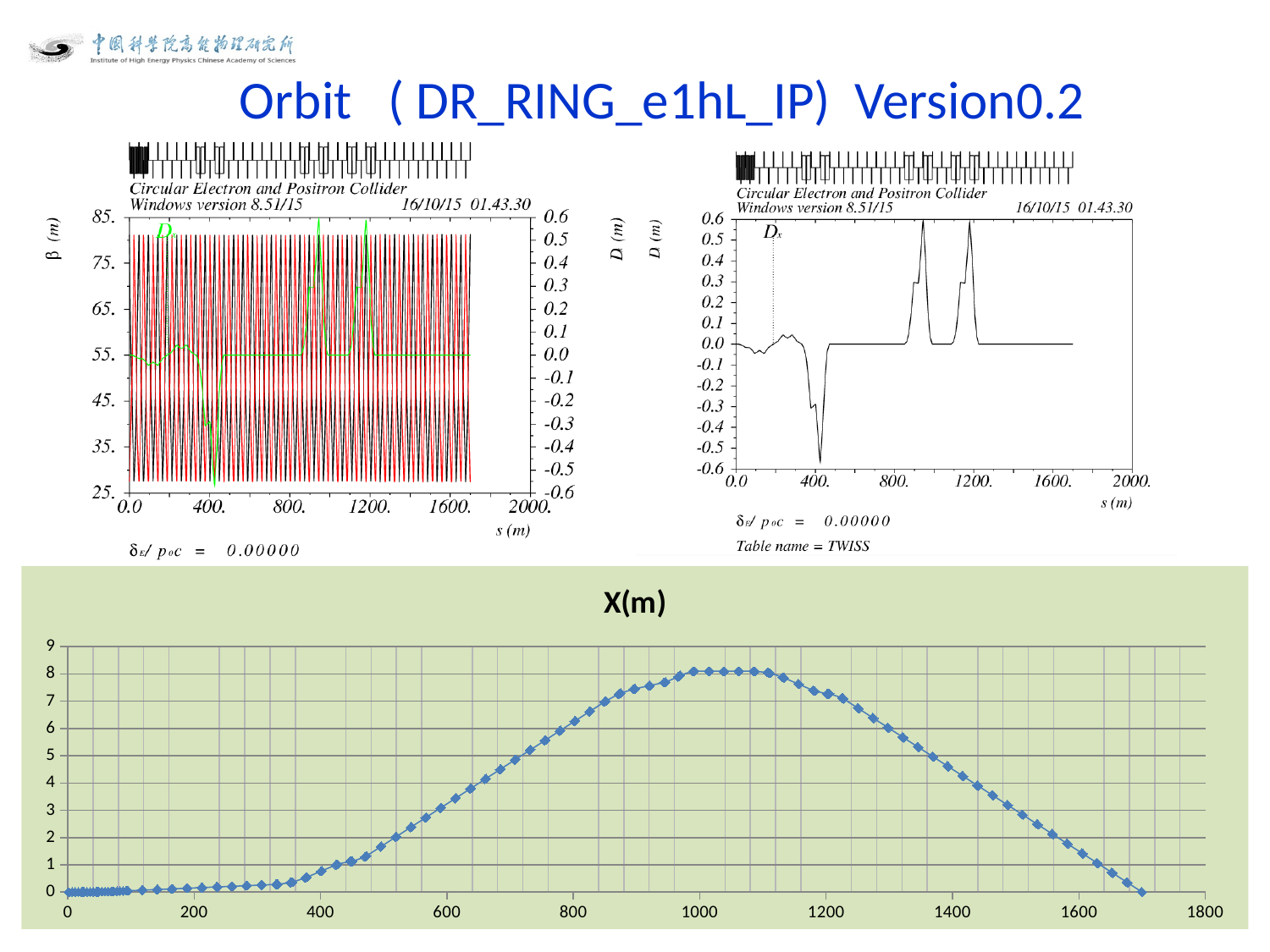
In the top-right chart, is the peak value of Dx near s = 950 greater or less than 0.5? greater In the bottom chart titled X(m), do the values rise or fall along the x axis between 1100 and 1700? fall In the bottom chart titled X(m), is the value at x = 600 greater or less than 4? less In the top-left chart, what is the label of the left y axis? β (m) In the bottom chart titled X(m), is the value at x = 800 greater or less than 6? greater In the bottom chart titled X(m), which is larger: the value at x = 1000 or the value at x = 1400? the value at x = 1000 In the bottom chart titled X(m), what is the highest tick shown on the y axis? 9 In the bottom chart titled X(m), do the values rise or fall along the x axis between 0 and 1000? rise In the top-right chart, what is the value of Dx at s = 1600? 0.0 What kind of chart is the bottom chart titled X(m)? line chart with markers